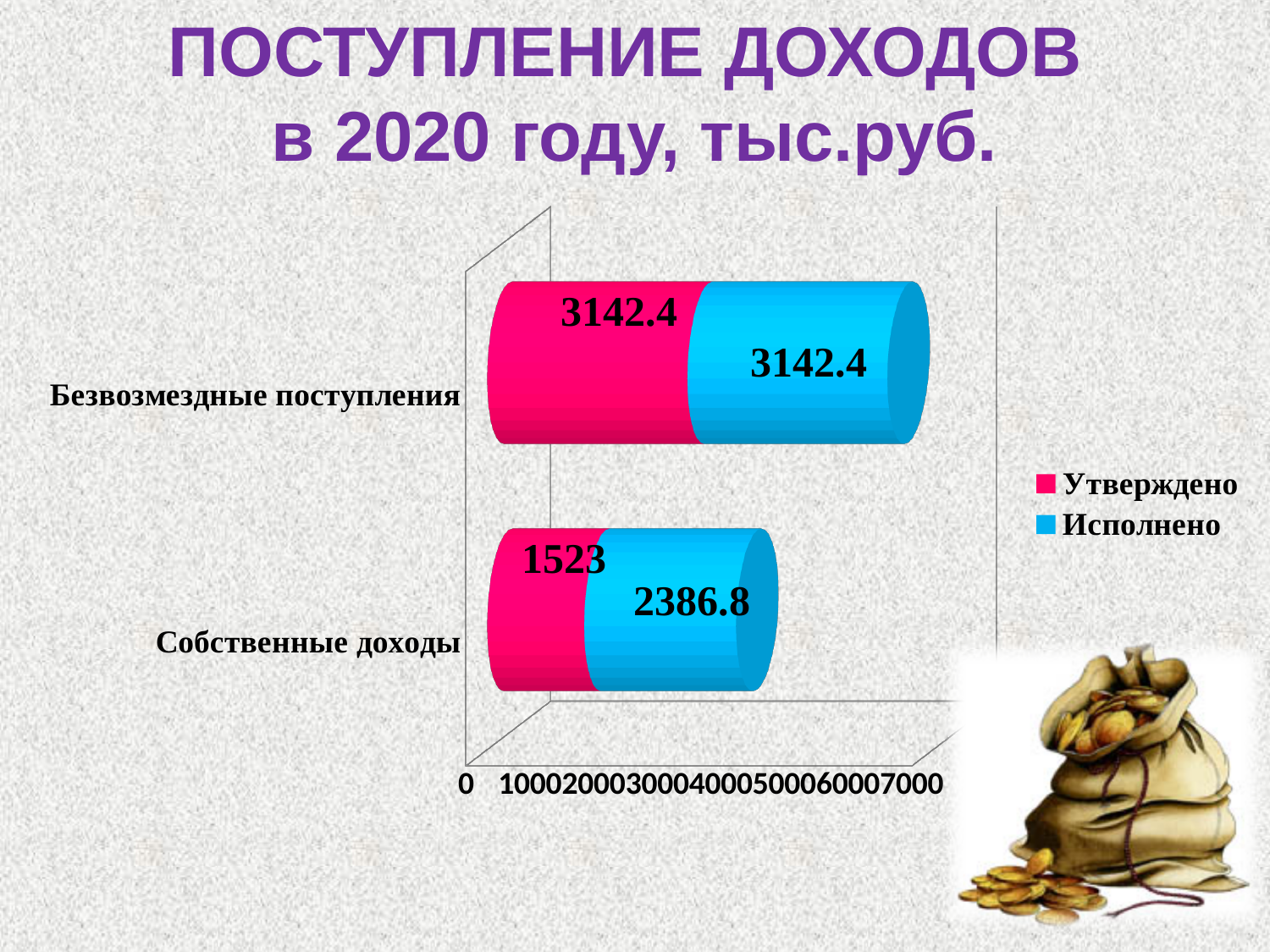
What is the Утверждено value for Собственные доходы? 1523 What is the Утверждено value for Безвозмездные поступления? 3142.4 What is the difference between the Исполнено and Утверждено values for Собственные доходы? 863.8 What is the Исполнено value for Собственные доходы? 2386.8 What is the Исполнено value for Безвозмездные поступления? 3142.4 How many series does the legend list? 2 What kind of chart is shown on the slide? Stacked bar chart What is the total of the stacked bar for Собственные доходы? 3909.8 For Собственные доходы, which is larger: Утверждено or Исполнено? Исполнено Which category has the lower Исполнено value? Собственные доходы Which category has the higher Утверждено value? Безвозмездные поступления What is the total of the stacked bar for Безвозмездные поступления? 6284.8